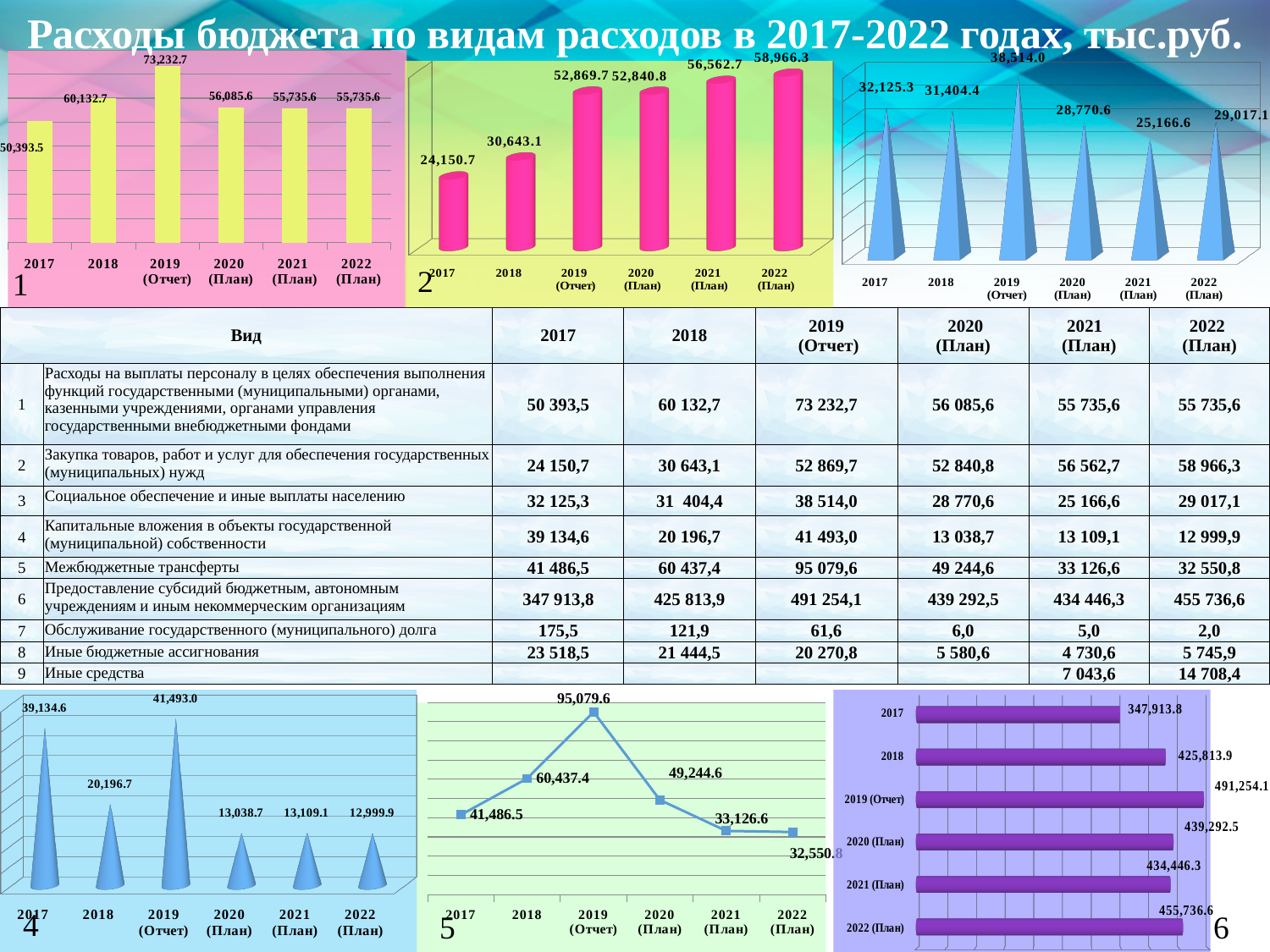
In chart 5 (bottom-middle), do the values rise or fall from 2019 (Отчет) to 2022 (План)? fall In chart 1 (top-left), what is the value for 2019 (Отчет)? 73,232.7 In chart 4 (bottom-left), how many years are plotted? 6 What kind of chart is chart 5 (bottom-middle)? line chart In chart 3 (top-right), which year has the highest value? 2019 (Отчет) In chart 2 (top-middle), what is the value for 2022 (План)? 58,966.3 In chart 4 (bottom-left), what is the value for 2018? 20,196.7 In chart 1 (top-left), which year has the lowest value? 2017 In chart 5 (bottom-middle), what is the value for 2019 (Отчет)? 95,079.6 In chart 2 (top-middle), what is the difference between the 2018 value and the 2017 value? 6,492.4 In chart 6 (bottom-right), what is the value for 2020 (План)? 439,292.5 In chart 3 (top-right), is the value for 2021 (План) larger or smaller than the value for 2022 (План)? smaller